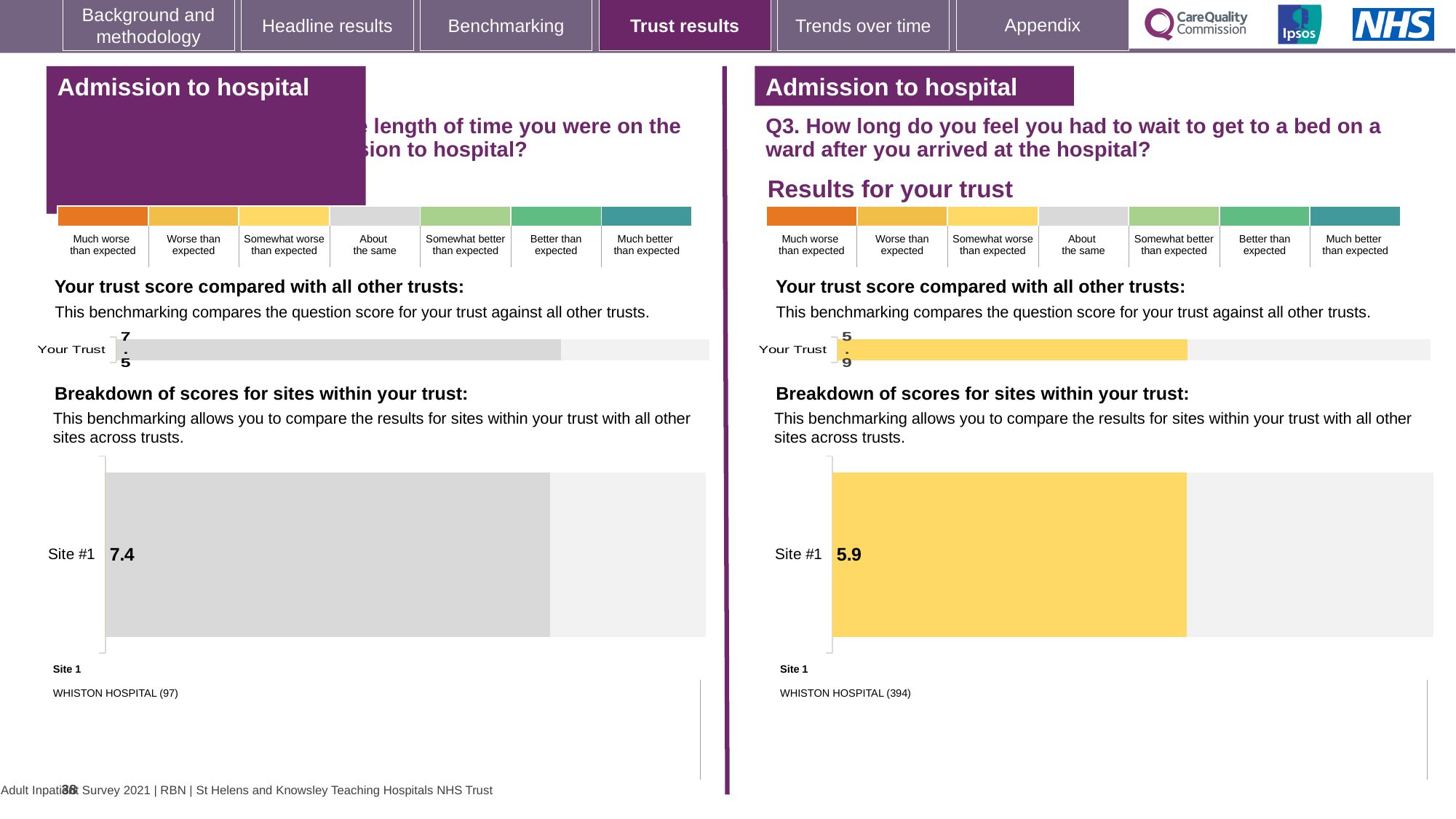
Which is larger: the Site #1 score on the left half of the slide or the Site #1 score on the right half (Q3)? Left half (7.4) On the left half of the slide, what is the score shown for 'Your Trust' in the trust benchmarking chart? 7.5 Which site name is listed under the site breakdown chart on the right half of the slide (Q3)? WHISTON HOSPITAL (394) On the right half of the slide (Q3), which benchmarking category does the yellow colour of the Site #1 bar correspond to in the legend? Somewhat worse than expected How many sites are shown in the site breakdown chart on the right half of the slide (Q3)? 1 On the left half of the slide, what is the difference between the 'Your Trust' score and the Site #1 score? 0.1 What is the difference between the Site #1 score on the left half of the slide (7.4) and the Site #1 score on the right half (5.9)? 1.5 On the right half of the slide (Q3), what is the score shown for Site #1 in the site breakdown chart? 5.9 On the left half of the slide, what is the score shown for Site #1 in the site breakdown chart? 7.4 On the right half of the slide (Q3), what is the score shown for 'Your Trust' in the trust benchmarking chart? 5.9 What type of chart is used to show the Site #1 score on the right half of the slide? Bar chart Is the 'Your Trust' score on the right half of the slide (Q3) greater or less than the 'Your Trust' score on the left half? less